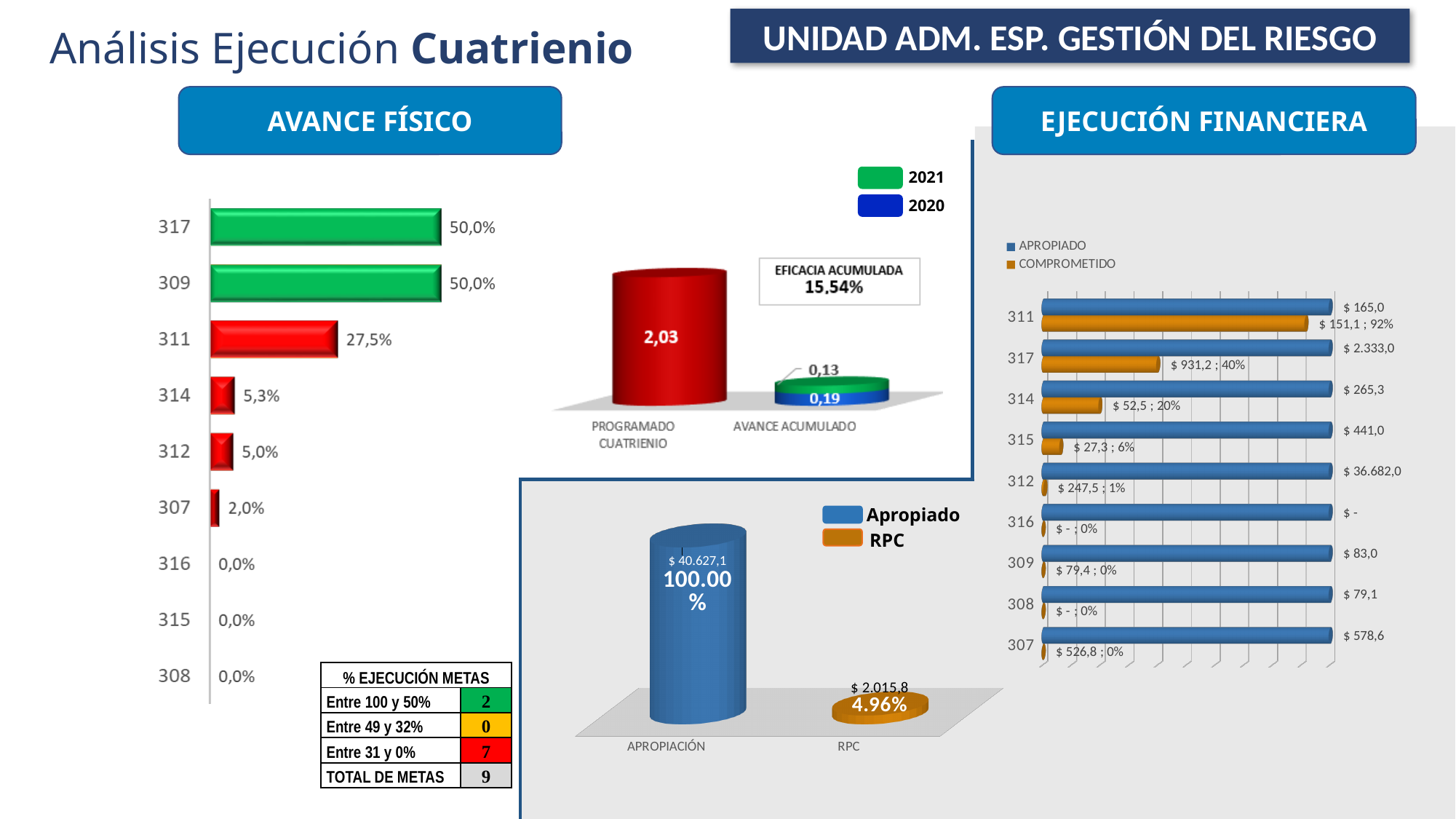
In the bottom-middle chart with the Apropiado and RPC legend, what is the value for RPC? $ 2.015,8 In the Ejecución Financiera chart on the right, what is the Apropiado value for category 312? $ 36.682,0 In the chart in the middle of the slide with the red cylinder, how many series does the legend list? 2 In the chart in the middle of the slide with the red cylinder, what is the value for Programado Cuatrienio? 2,03 In the Avance Físico bar chart on the left, what is the value for category 314? 5,3% In the Avance Físico bar chart on the left, which is larger, the value for 314 or the value for 307? 314 In the Avance Físico bar chart on the left, how many categories are plotted? 9 In the Avance Físico bar chart on the left, what is the value for category 311? 27,5% In the Ejecución Financiera chart on the right, what kind of chart is it? bar chart In the Avance Físico bar chart on the left, what is the difference between the values for 311 and 312? 22,5% In the Ejecución Financiera chart on the right, which category has the highest Apropiado value? 312 In the bottom-middle chart with the Apropiado and RPC legend, what percentage is shown for Apropiación? 100.00%